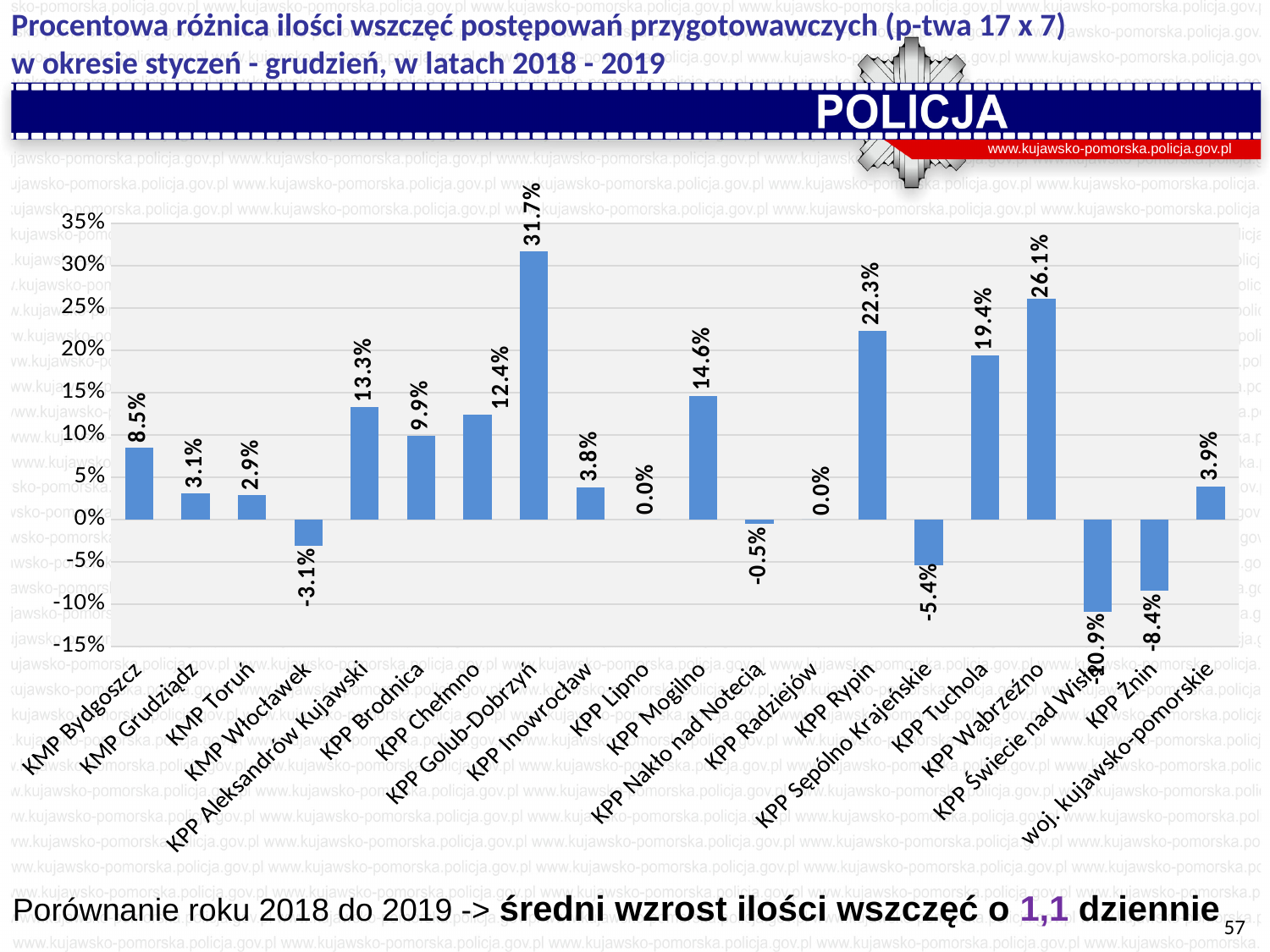
What is the value shown for KMP Bydgoszcz? 8.5% What is the value shown for woj. kujawsko-pomorskie? 3.9% Which category has the lowest value? KPP Świecie nad Wisłą Is the value for KPP Rypin greater or less than 20%? greater How many categories are shown on the x axis? 20 What is the difference between the values for KPP Wąbrzeźno and KPP Rypin? 3.8% Which category has the highest value? KPP Golub-Dobrzyń What is the value shown for KPP Świecie nad Wisłą? -10.9% Which is larger, the value for KPP Tuchola or the value for KPP Mogilno? KPP Tuchola Which two categories have a value of 0.0%? KPP Lipno and KPP Radziejów What is the value shown for KPP Golub-Dobrzyń? 31.7% What kind of chart is shown on the slide? bar chart